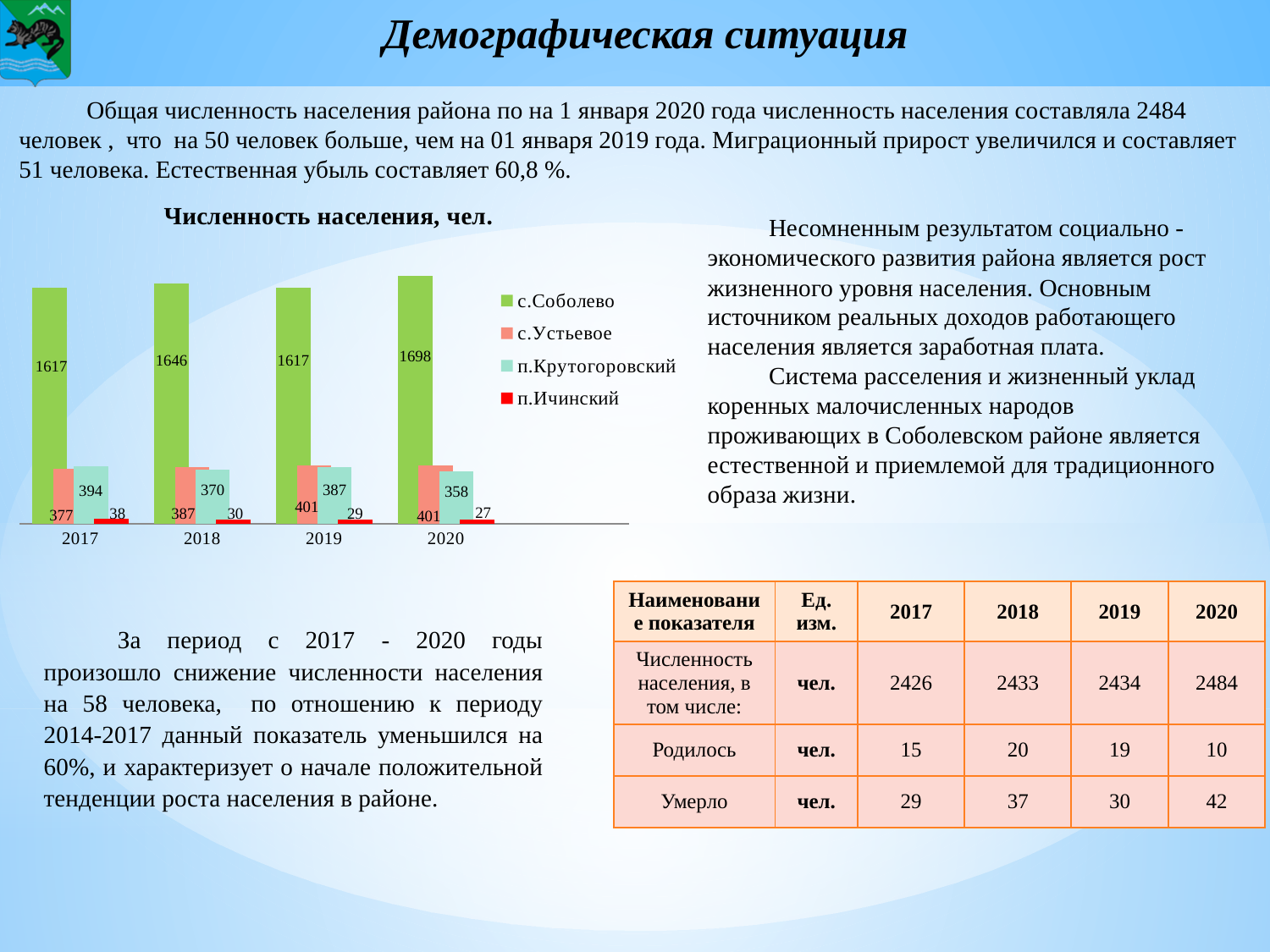
How many series does the legend of the chart 'Численность населения, чел.' list? 4 What is the value for с.Устьевое in 2019 on the chart 'Численность населения, чел.'? 401 Do the values for п.Ичинский rise or fall from 2017 to 2020 on the chart 'Численность населения, чел.'? fall In which year is the value for с.Соболево highest on the chart 'Численность населения, чел.'? 2020 In which year is the value for п.Ичинский lowest on the chart 'Численность населения, чел.'? 2020 What is the value for с.Соболево in 2020 on the chart 'Численность населения, чел.'? 1698 What is the value for п.Ичинский in 2018 on the chart 'Численность населения, чел.'? 30 How many years are shown on the x axis of the chart 'Численность населения, чел.'? 4 What is the value for п.Крутогоровский in 2017 on the chart 'Численность населения, чел.'? 394 Which is larger in 2018 on the chart 'Численность населения, чел.': с.Устьевое or п.Крутогоровский? с.Устьевое What is the difference between the с.Соболево values for 2020 and 2019 on the chart 'Численность населения, чел.'? 81 What kind of chart is 'Численность населения, чел.'? bar chart